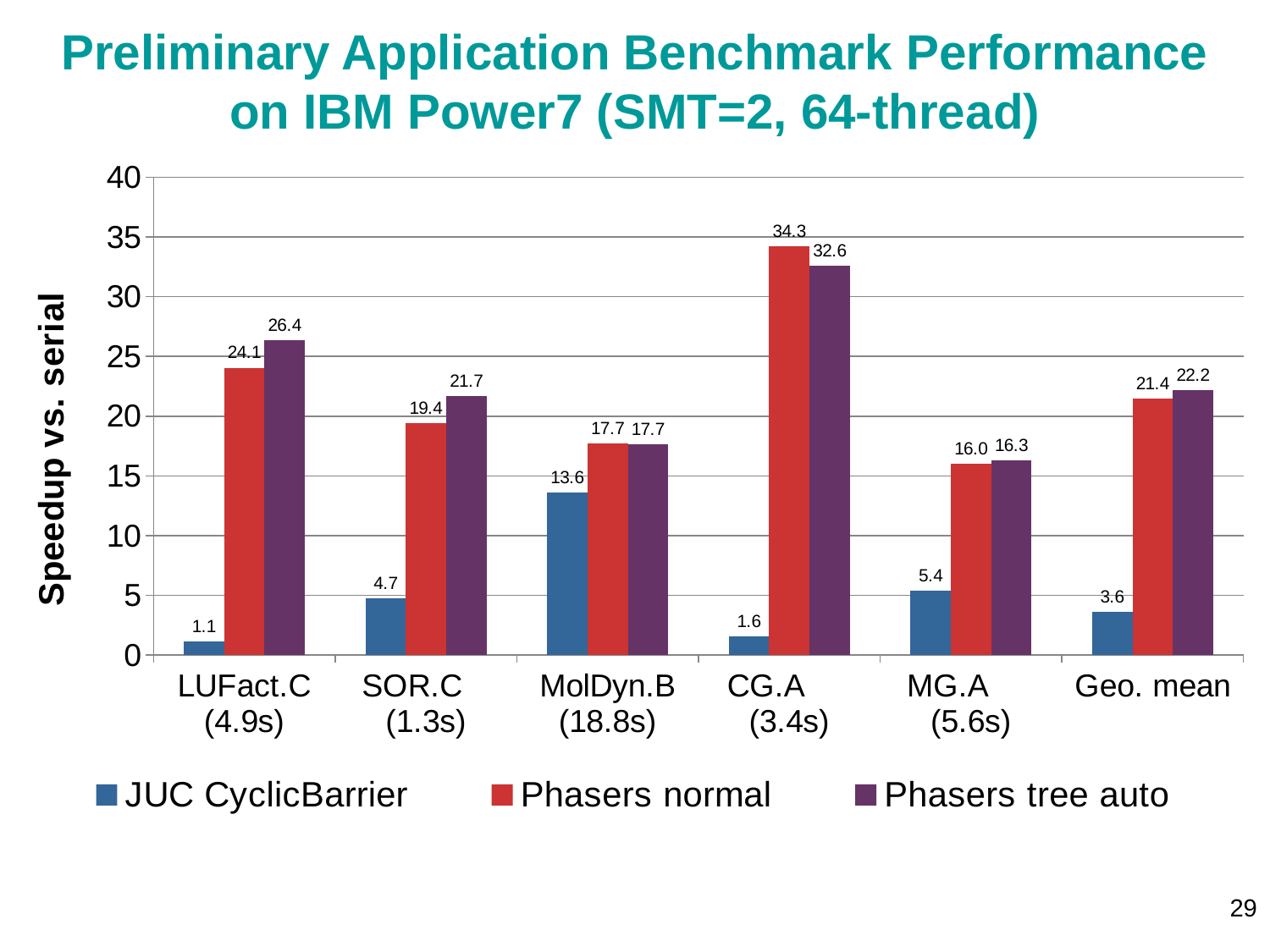
Which benchmark has the lowest JUC CyclicBarrier speedup? LUFact.C What is the speedup for Phasers normal on CG.A? 34.3 How many series does the legend list? 3 What is the label of the y axis? Speedup vs. serial What is the difference between the Phasers normal and Phasers tree auto speedups on CG.A? 1.7 How many benchmark categories are shown on the x axis? 6 What kind of chart is shown on the slide? Bar chart Which is larger on MG.A: the Phasers normal speedup or the Phasers tree auto speedup? Phasers tree auto What is the speedup for Phasers tree auto on SOR.C? 21.7 Which benchmark has the highest Phasers normal speedup? CG.A Is the JUC CyclicBarrier speedup for MolDyn.B greater or less than 10? greater What is the speedup for JUC CyclicBarrier on LUFact.C? 1.1